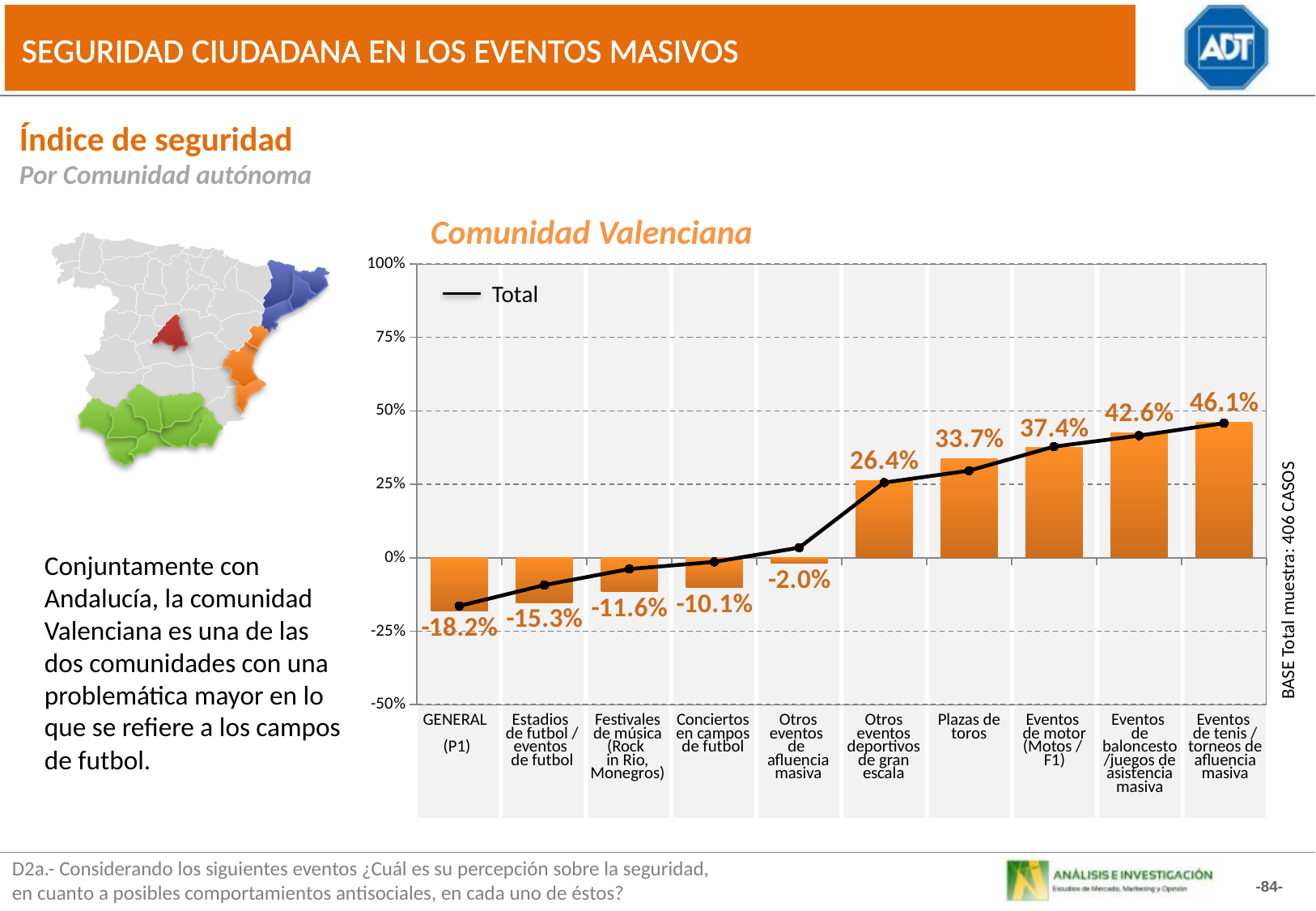
Is the value for Eventos de baloncesto/juegos de asistencia masiva greater or less than 50%? less What is the value shown for Plazas de toros? 33.7% Which is larger, the value for Otros eventos deportivos de gran escala or the value for Plazas de toros? Plazas de toros Do the values rise or fall from left to right along the x axis? rise Which category has the lowest value? GENERAL (P1) How many categories are shown on the x axis? 10 What kind of chart is this? Bar chart with a line What is the difference between the values for Eventos de tenis / torneos de afluencia masiva and Eventos de baloncesto/juegos de asistencia masiva? 3.5% How many series does the legend list? 1 What is the value shown for GENERAL (P1)? -18.2% Which category has the highest value? Eventos de tenis / torneos de afluencia masiva What is the value shown for Eventos de motor (Motos / F1)? 37.4%